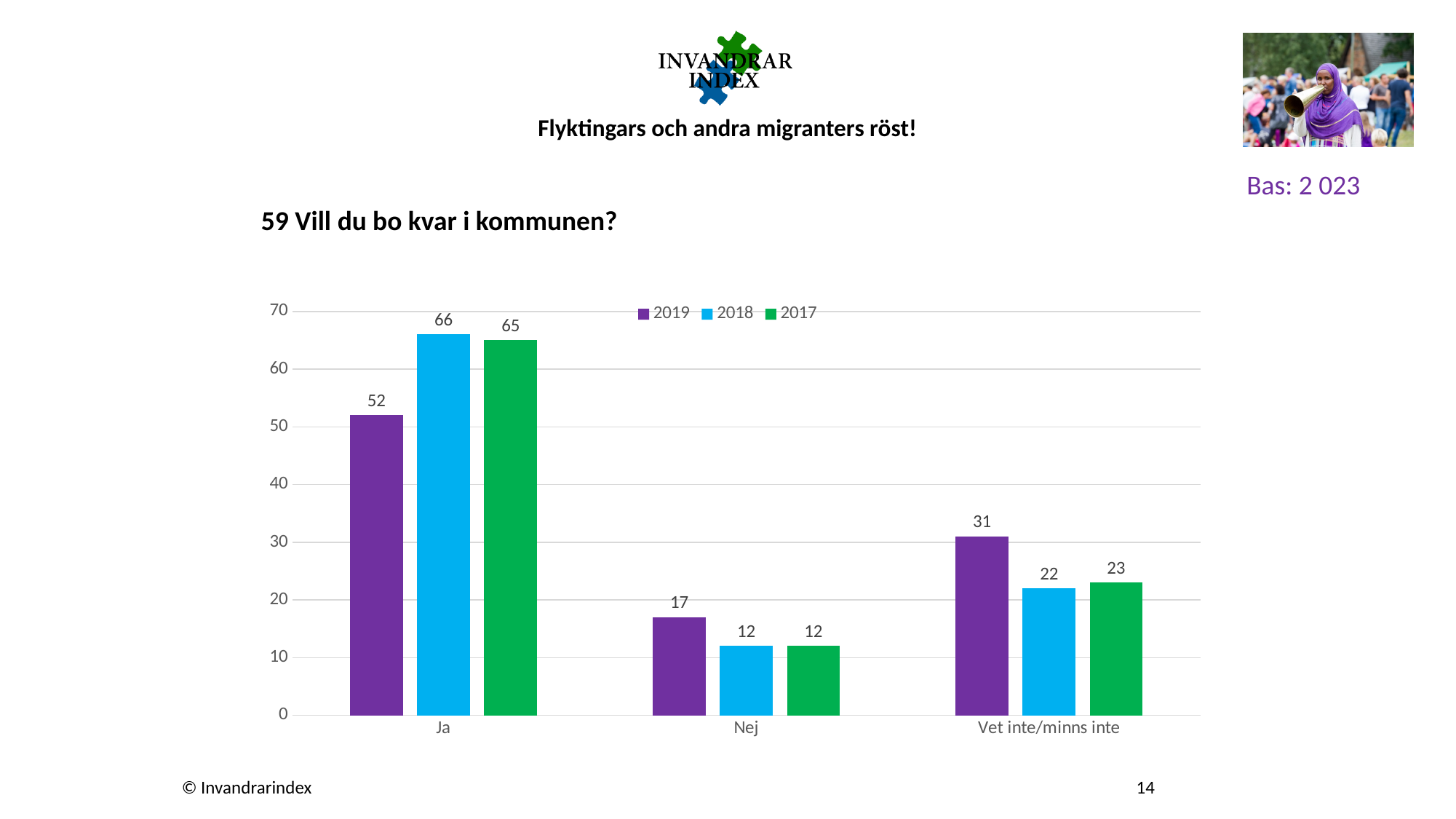
Which category has the highest value for the 2018 series? Ja What is the difference between the 2019 and 2017 values in the Nej category? 5 How many series does the legend list? 3 Which category has the lowest value for the 2019 series? Nej What is the value for 2019 in the Ja category? 52 What is the title of the chart? 59 Vill du bo kvar i kommunen? What is the value for 2018 in the Nej category? 12 How many categories are shown on the x axis? 3 Which is larger in the Vet inte/minns inte category: the 2019 value or the 2018 value? 2019 What kind of chart is shown on the slide? Bar chart What is the difference between the 2018 and 2019 values in the Ja category? 14 What is the value for 2017 in the Vet inte/minns inte category? 23